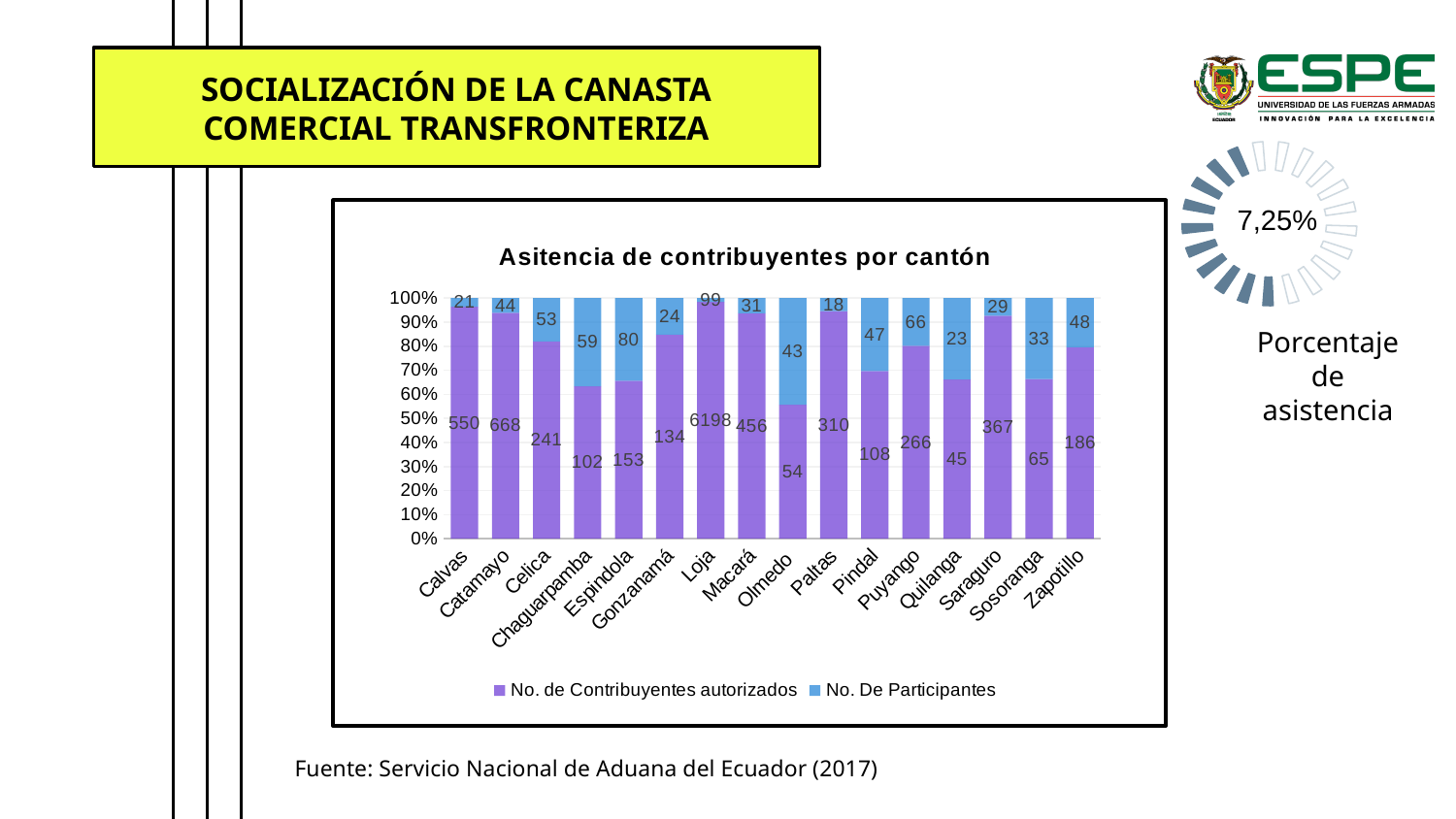
Which cantón has the lowest number of participantes? Paltas Which has more participantes, Puyango or Pindal? Puyango What is the value of No. de Contribuyentes autorizados for Saraguro? 367 What kind of chart is shown? Stacked bar chart How many cantones are shown on the x axis? 16 What is the difference between the contribuyentes autorizados of Catamayo and Calvas? 118 How many series does the legend list? 2 How many contribuyentes autorizados are shown for Calvas? 550 How many participantes are shown for Olmedo? 43 What is the title of the chart? Asitencia de contribuyentes por cantón What is the number of participantes for Espindola? 80 Which cantón has the highest number of participantes? Loja